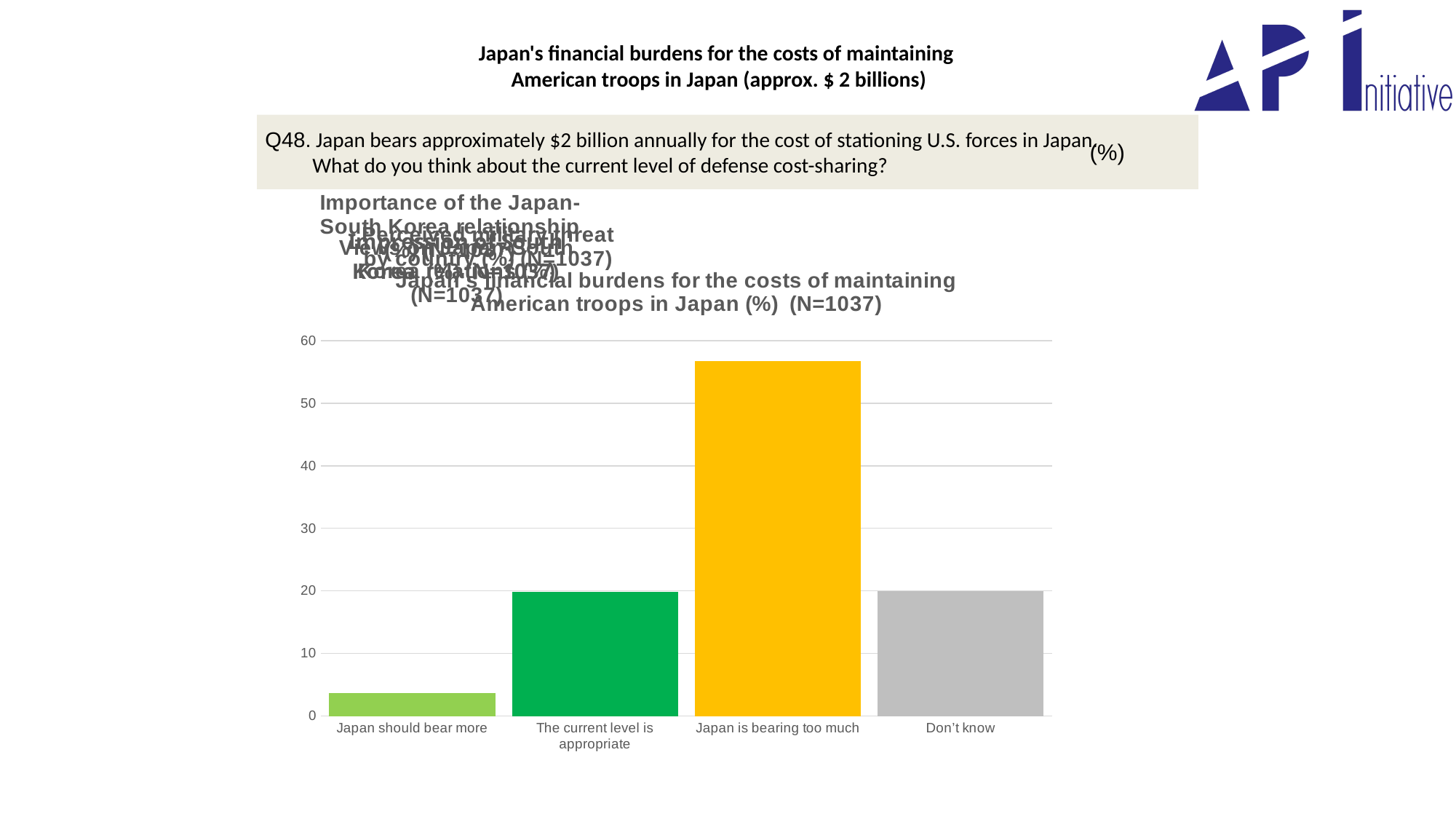
What is the sample size (N) stated in the chart title? N=1037 Is the value for "Japan should bear more" greater or less than 10? less What kind of chart is shown on the slide? bar chart Which response category has the lowest bar? Japan should bear more What colour is the bar for "Japan is bearing too much"? yellow Is the value for "The current level is appropriate" greater or less than 30? less Is the value for "Don't know" greater or less than 10? greater Which is larger, the value for "Japan is bearing too much" or the value for "The current level is appropriate"? Japan is bearing too much How many response categories are shown on the x axis of the chart? 4 Which response category has the highest bar? Japan is bearing too much